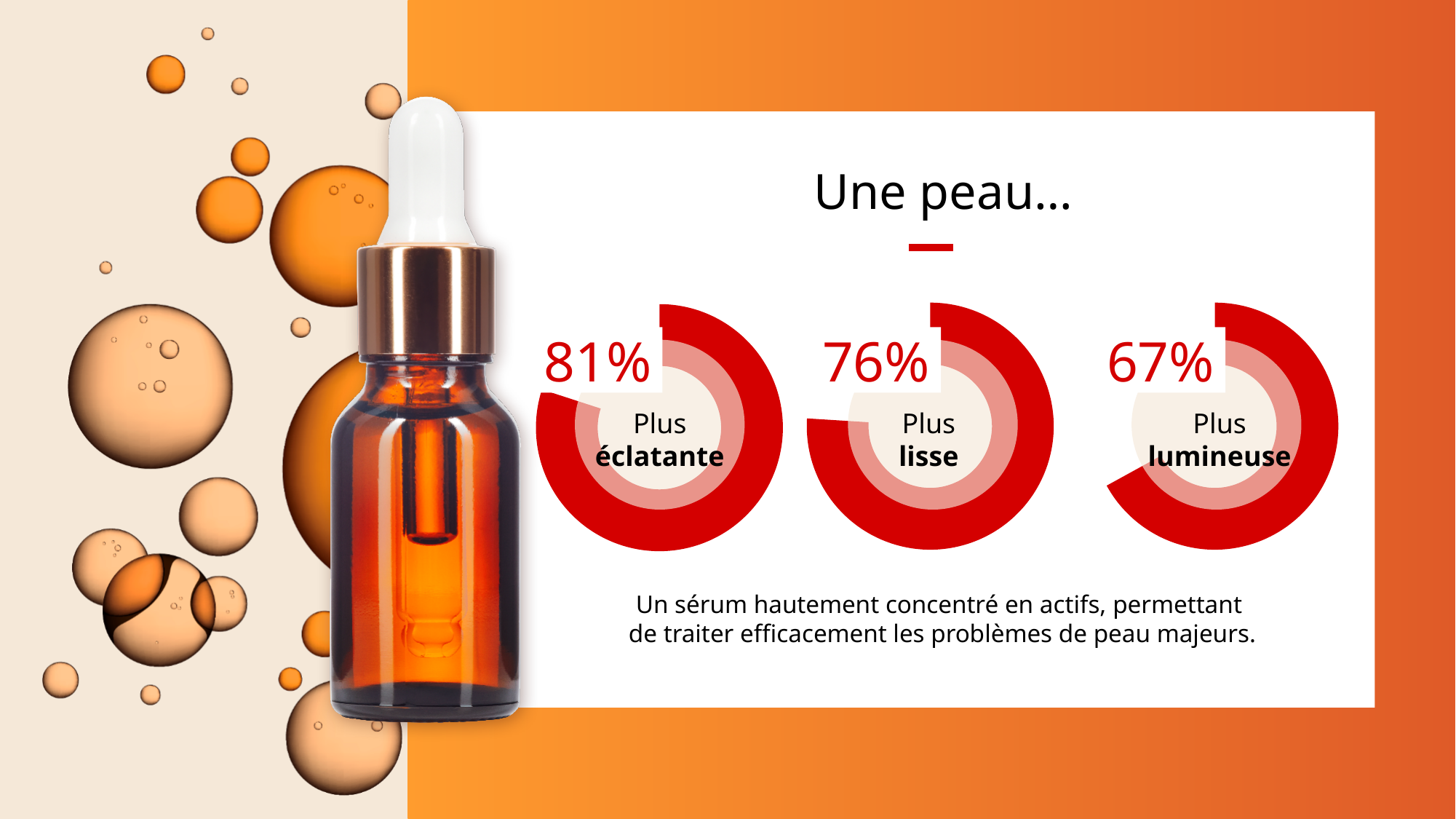
What percentage is shown for "Plus lisse"? 76% Which is larger, the percentage for "Plus lisse" or for "Plus lumineuse"? Plus lisse What percentage is shown for "Plus éclatante"? 81% What kind of chart is used to display the percentages? Donut chart What is the title above the charts? Une peau... How many ring charts are shown on the slide? 3 What colour is the filled portion of each ring chart? Red What is the difference between the percentages for "Plus éclatante" and "Plus lisse"? 5% What percentage is shown for "Plus lumineuse"? 67% What is the difference between the percentages for "Plus éclatante" and "Plus lumineuse"? 14% Which of the three skin benefits has the lowest percentage? Plus lumineuse Which of the three skin benefits has the highest percentage? Plus éclatante